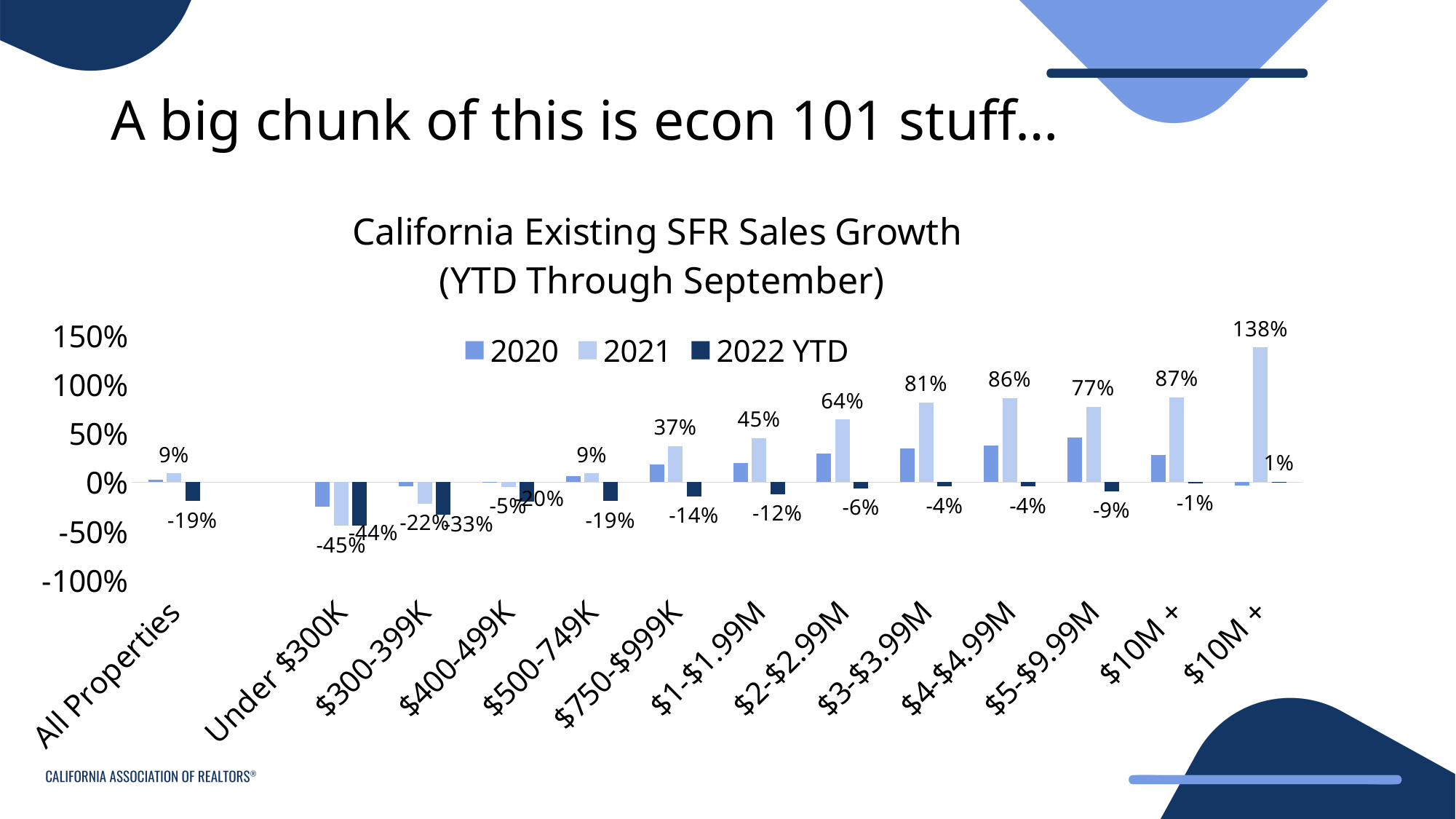
What is the 2022 YTD value for All Properties? -19% How many series does the legend list? 3 What kind of chart is shown on the slide? Bar chart What is the 2021 value for the Under $300K category? -45% What is the 2022 YTD value for the $300-399K category? -33% Which has the larger 2021 value, $1-$1.99M or $750-$999K? $1-$1.99M Is the 2020 value for $4-$4.99M greater or less than 50%? less What is the 2022 YTD value for the $2-$2.99M category? -6% What is the 2021 value for the $5-$9.99M category? 77% What is the highest 2021 value shown on the chart? 138% Which category has the lowest 2021 value? Under $300K What is the difference between the 2021 values for $4-$4.99M and $3-$3.99M? 5 percentage points